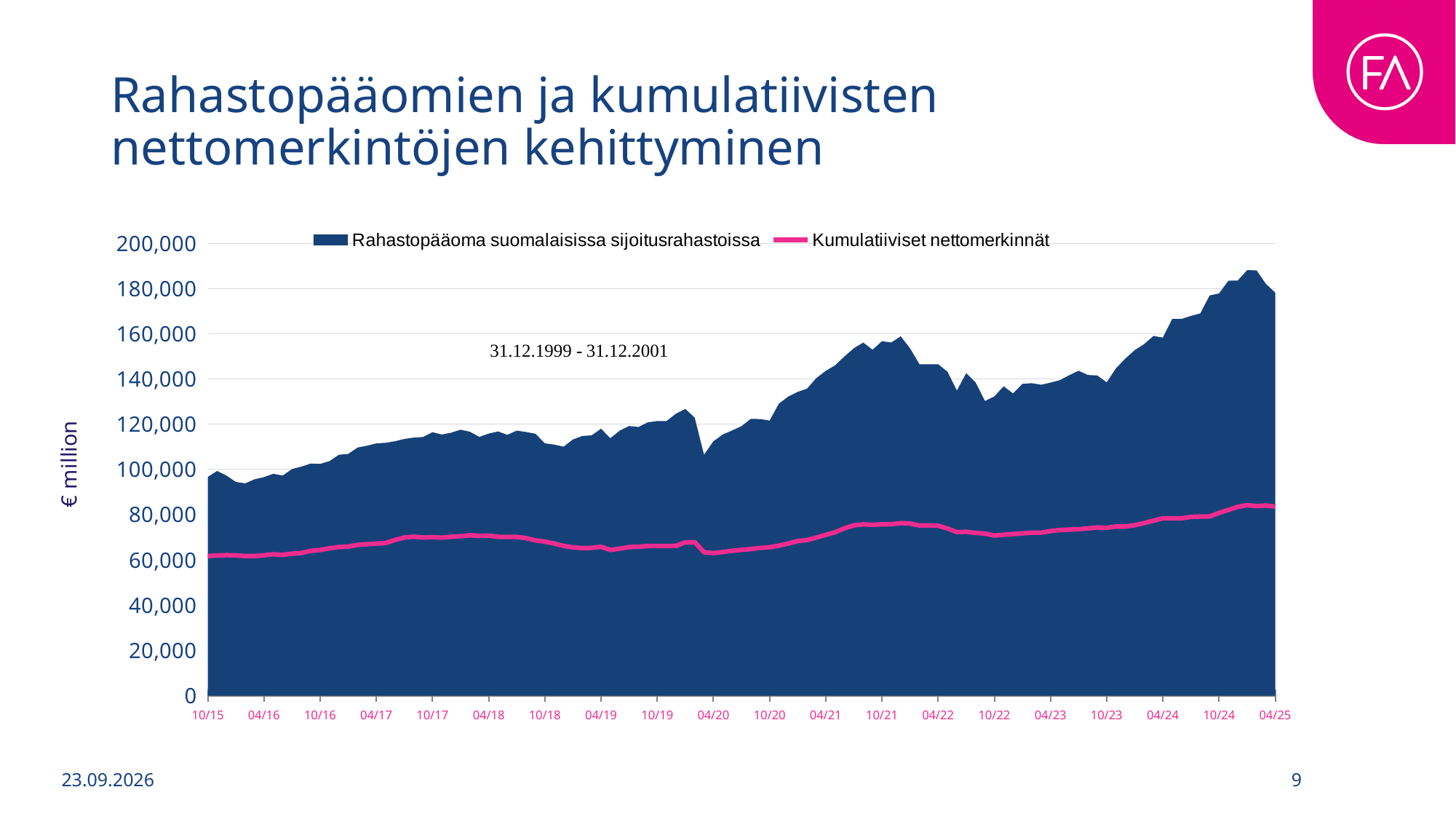
How many series does the chart legend list? 2 Does the value of Rahastopääoma suomalaisissa sijoitusrahastoissa overall rise or fall from 10/15 to 04/25? rise Is the peak value of Rahastopääoma suomalaisissa sijoitusrahastoissa around 10/24 greater or less than 180,000? greater Does the value of Kumulatiiviset nettomerkinnät overall rise or fall from 10/15 to 04/25? rise What is the highest value shown on the vertical axis of the chart? 200,000 Is the value of Rahastopääoma suomalaisissa sijoitusrahastoissa at 04/20 greater or less than 100,000? greater How many date labels are shown along the x axis of the chart? 20 What kind of chart is shown on the slide? Area chart with a line What unit is shown on the vertical axis of the chart? € million Is the value of Kumulatiiviset nettomerkinnät at 04/25 greater or less than 80,000? greater Which series has the larger value at 04/25, Rahastopääoma suomalaisissa sijoitusrahastoissa or Kumulatiiviset nettomerkinnät? Rahastopääoma suomalaisissa sijoitusrahastoissa